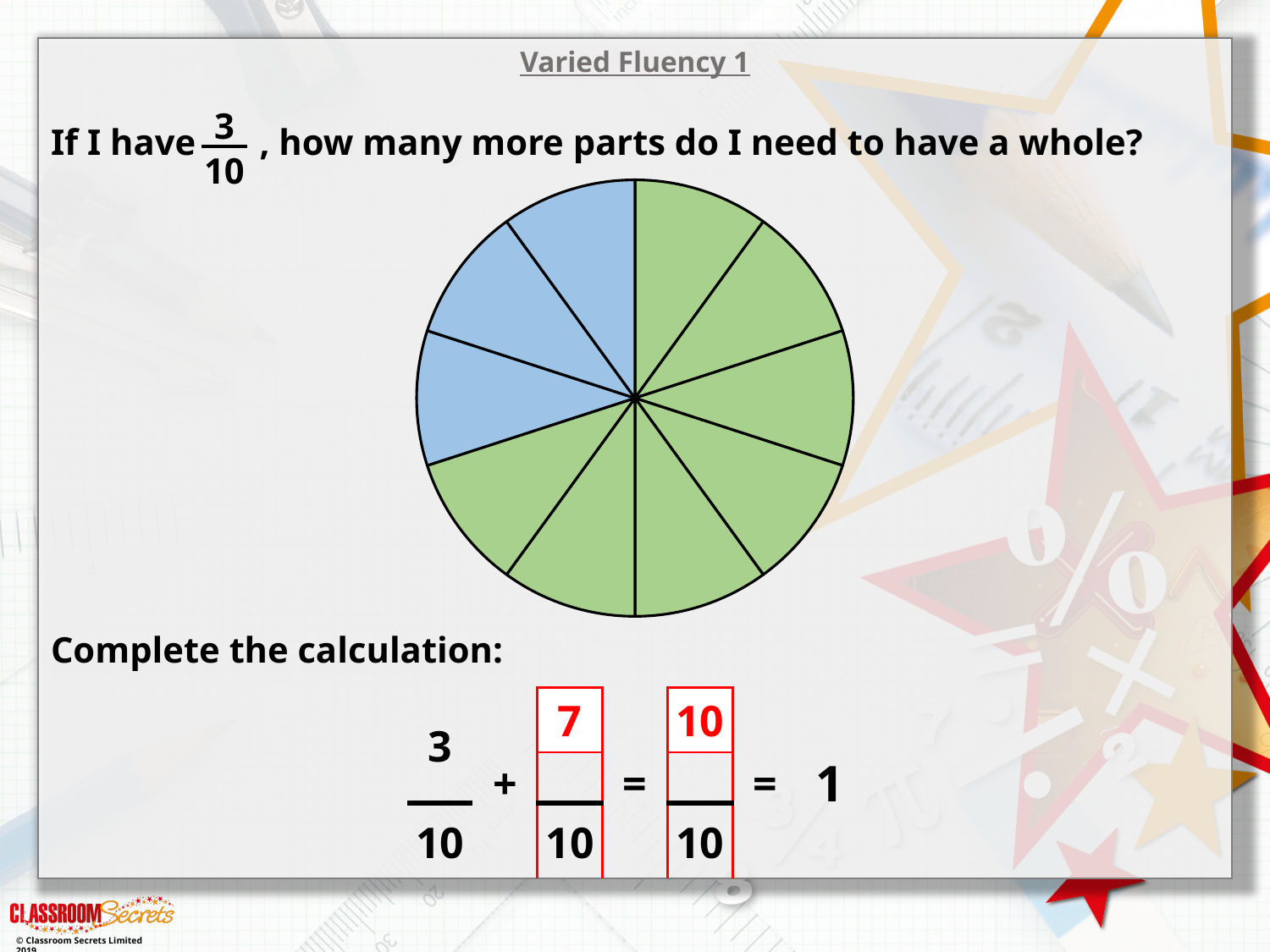
Which colour covers more of the circle, blue or green? green What fraction of the circle is shaded green? 7/10 What is the title at the top of the slide? Varied Fluency 1 What fraction is shown in the second red box of the calculation? 10/10 How many more green parts are there than blue parts? 4 How many parts of the circle are shaded blue? 3 What kind of chart is shown on the slide? pie chart What fraction of the circle is shaded blue? 3/10 How many equal parts is the circle divided into? 10 What is the total of 3/10 and 7/10 as shown in the calculation? 1 How many parts of the circle are shaded green? 7 According to the completed calculation, how many more parts are needed to make a whole from 3/10? 7